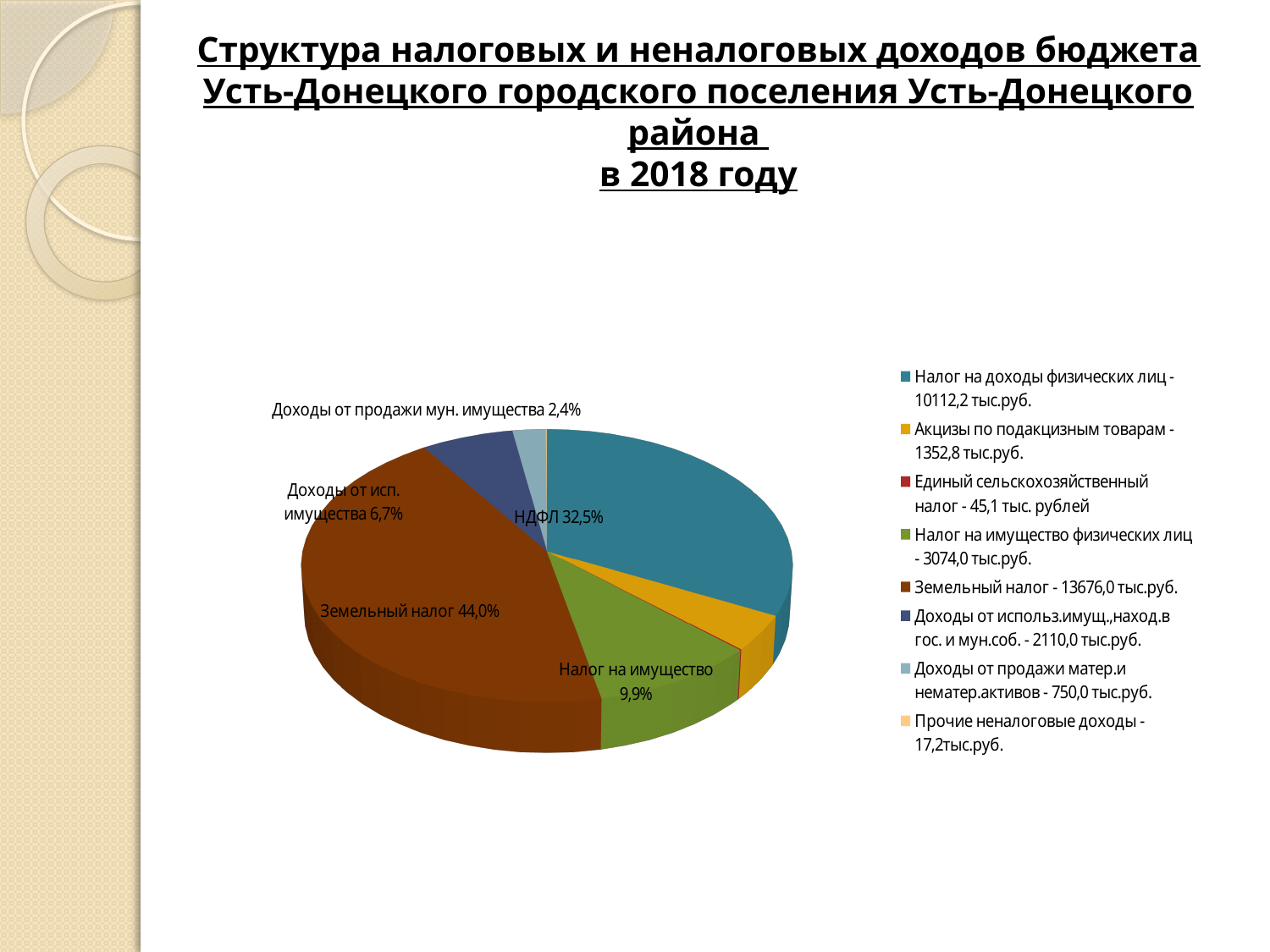
What share of the pie does Земельный налог have? 44,0% Which category has the largest slice of the pie? Земельный налог How many categories does the legend list? 8 What kind of chart is shown on the slide? pie chart What share of the pie does НДФЛ have? 32,5% According to the legend, what is the amount for Земельный налог? 13676,0 тыс.руб. What share of the pie does Налог на имущество have? 9,9% Which slice is larger: Доходы от исп. имущества or Налог на имущество? Налог на имущество According to the legend, what is the amount for Налог на доходы физических лиц? 10112,2 тыс.руб. Which category in the legend has the smallest amount? Прочие неналоговые доходы - 17,2 тыс.руб. What is the difference in percentage points between the Земельный налог slice and the НДФЛ slice? 11,5%